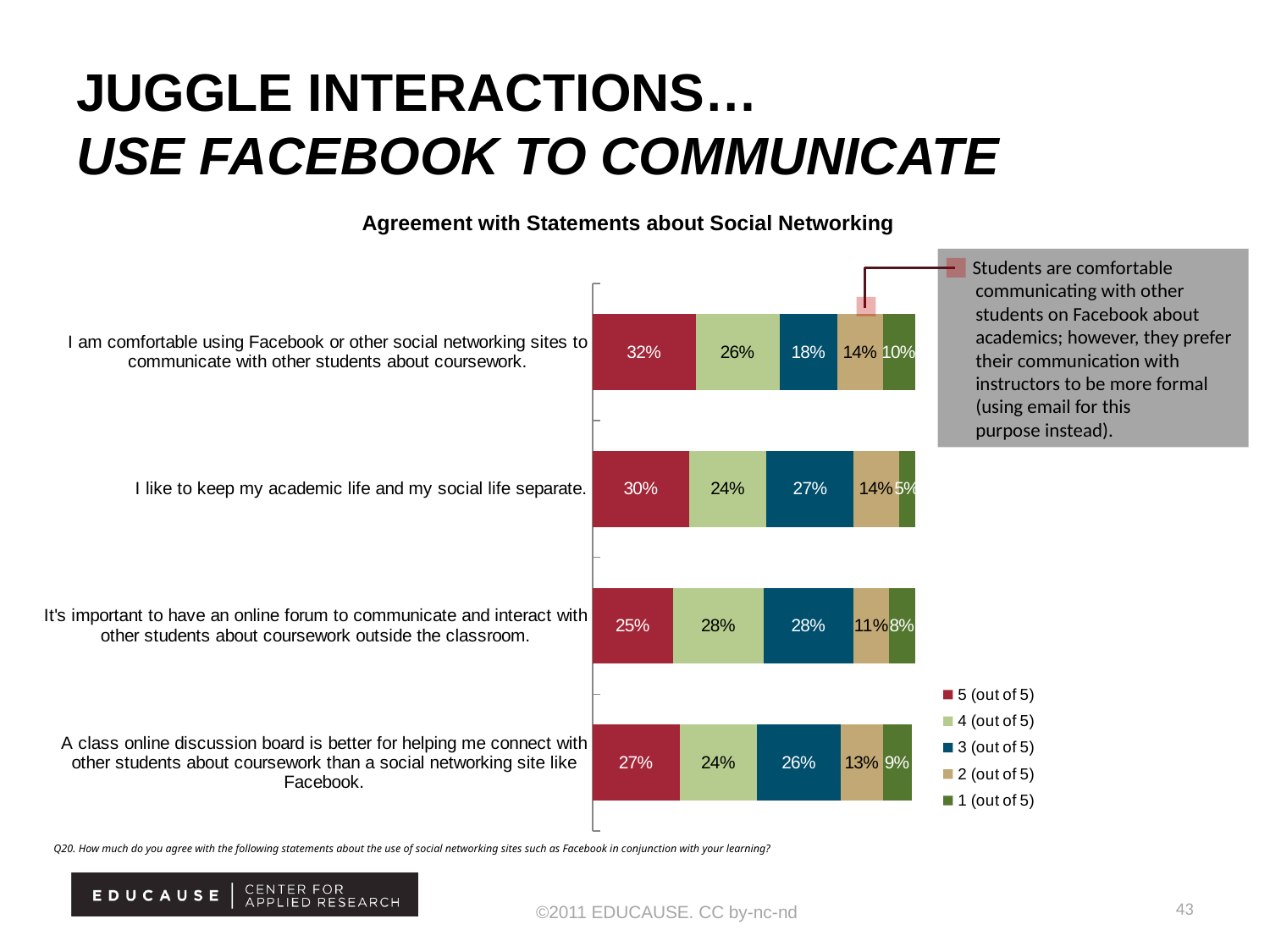
Which statement has the lowest share of 1 (out of 5) ratings? I like to keep my academic life and my social life separate. What percentage of respondents rated "I am comfortable using Facebook or other social networking sites to communicate with other students about coursework" as 5 (out of 5)? 32% What percentage rated "It's important to have an online forum to communicate and interact with other students about coursework outside the classroom" as 3 (out of 5)? 28% What is the difference between the 5 (out of 5) share for "I am comfortable using Facebook..." (32%) and for "It's important to have an online forum..." (25%)? 7% What percentage rated "I like to keep my academic life and my social life separate" as 1 (out of 5)? 5% How many series does the legend list? 5 How many statements (categories) are plotted in the chart? 4 What percentage rated "A class online discussion board is better for helping me connect with other students about coursework than a social networking site like Facebook" as 2 (out of 5)? 13% Which is larger: the 3 (out of 5) share for "I like to keep my academic life and my social life separate" or for "I am comfortable using Facebook or other social networking sites to communicate with other students about coursework"? I like to keep my academic life and my social life separate. Which statement has the highest share of 5 (out of 5) ratings? I am comfortable using Facebook or other social networking sites to communicate with other students about coursework. What is the title of the chart? Agreement with Statements about Social Networking What kind of chart is shown on the slide? Stacked bar chart